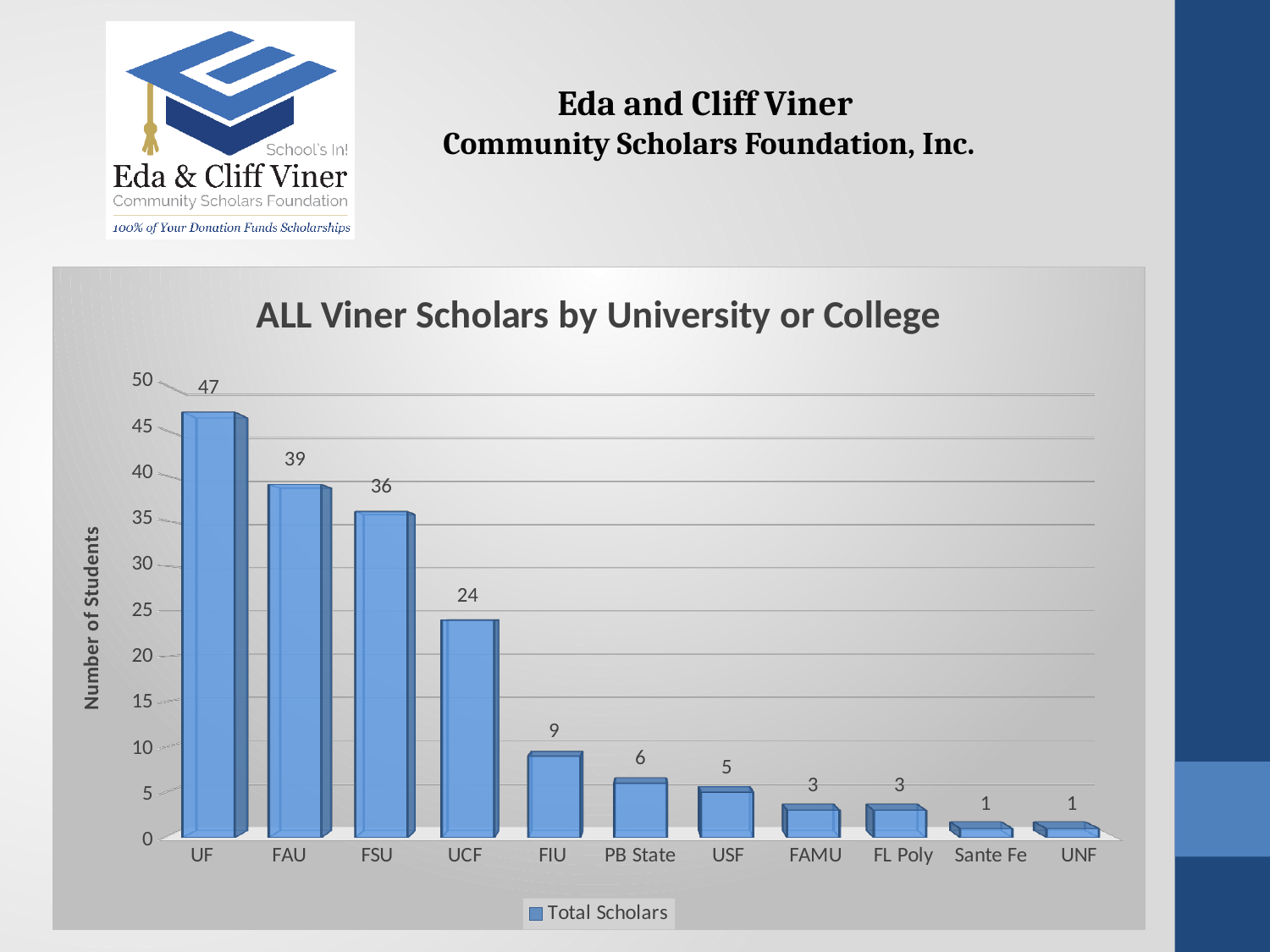
How many Viner scholars attended UF? 47 How many scholars are shown for PB State? 6 What is the number of students for UCF? 24 Which university or college has the highest number of students? UF Which categories have the lowest number of students? Sante Fe and UNF What is the difference between the number of students at FAU and FSU? 3 Which has more students, FIU or USF? FIU What is the title of the chart? ALL Viner Scholars by University or College What type of chart is shown on the slide? Bar chart How many series does the legend list? 1 What is the difference between the number of students at UF and UCF? 23 How many universities or colleges are shown on the x axis? 11